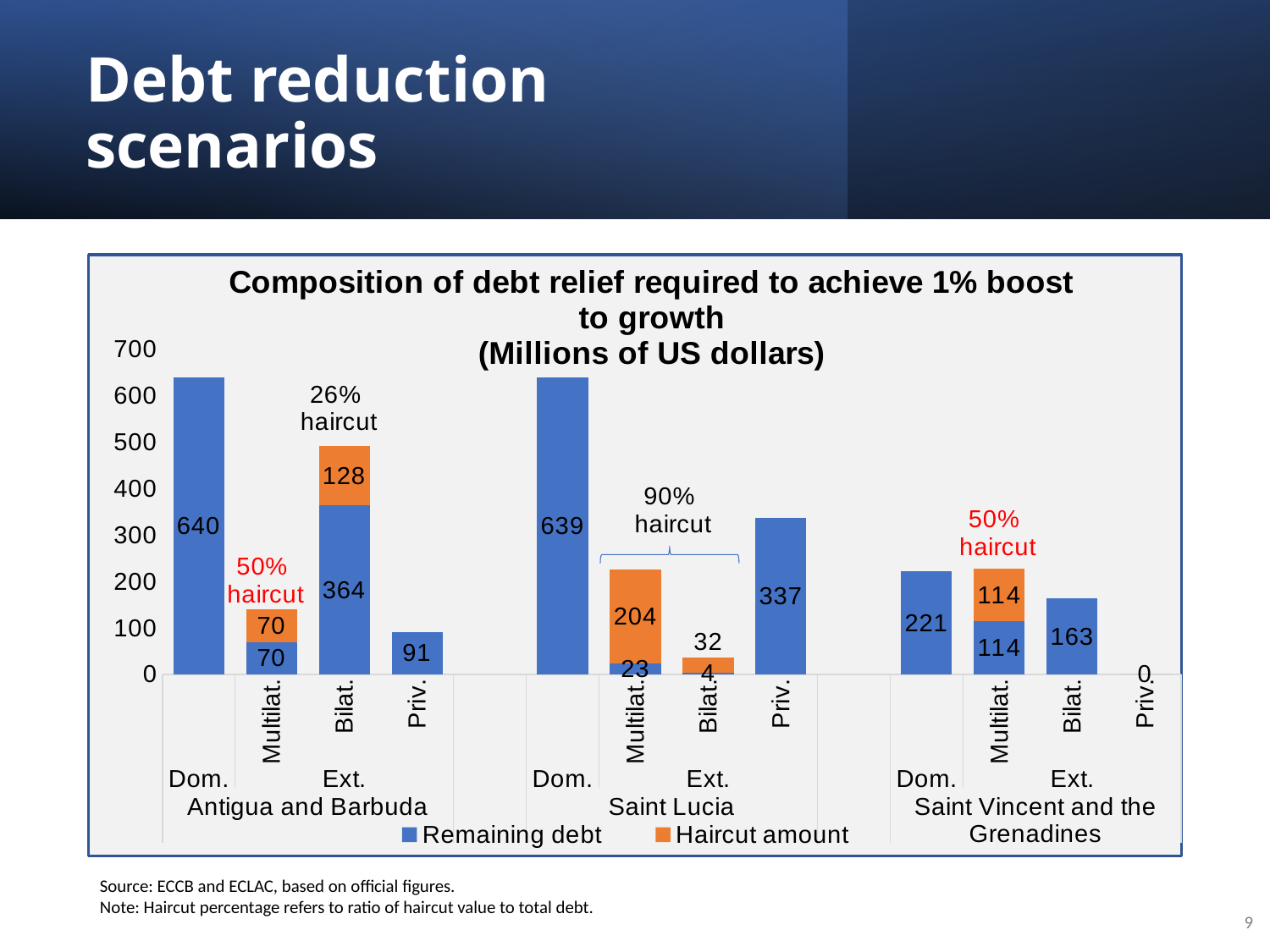
How many countries are shown on the x axis of the chart? 3 What kind of chart is shown on the slide? Stacked bar chart What haircut percentage is annotated for the Multilat. and Bilat. bars of Saint Lucia? 90% haircut What is the total height of the Multilat. bar for Saint Lucia (remaining debt plus haircut amount)? 227 How many series does the legend list? 2 What is the difference between the Dom. remaining debt of Antigua and Barbuda and that of Saint Lucia? 1 What is the total height of the Bilat. bar for Antigua and Barbuda (remaining debt plus haircut amount)? 492 What is the haircut amount for Multilat. in Saint Vincent and the Grenadines? 114 What is the remaining debt for Priv. in Saint Lucia? 337 Which is larger: the Dom. remaining debt for Saint Vincent and the Grenadines or the Priv. remaining debt for Saint Lucia? Priv. remaining debt for Saint Lucia What is the haircut amount for Bilat. in Antigua and Barbuda? 128 What is the remaining debt for Dom. in Antigua and Barbuda? 640